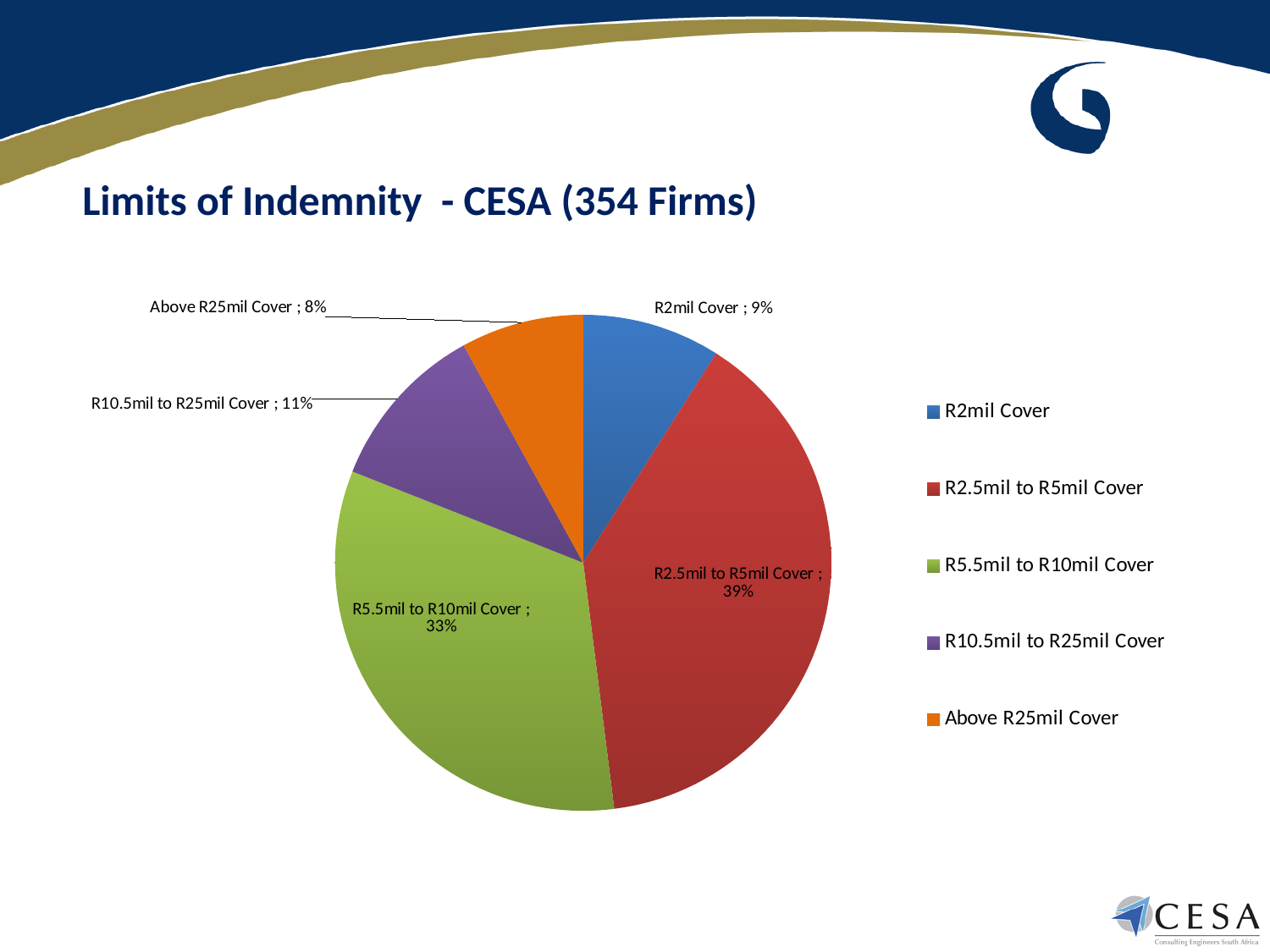
What share of the pie does R5.5mil to R10mil Cover represent? 33% What is the value shown for R2mil Cover? 9% Which category has the smallest slice of the pie? Above R25mil Cover What is the difference in percentage points between R2.5mil to R5mil Cover and R5.5mil to R10mil Cover? 6 Which is larger, the share for R2mil Cover or the share for R10.5mil to R25mil Cover? R10.5mil to R25mil Cover How many categories are shown in the pie chart? 5 What kind of chart is shown on the slide? Pie chart What is the value shown for Above R25mil Cover? 8% What share of the pie does R2.5mil to R5mil Cover represent? 39% What is the value shown for R10.5mil to R25mil Cover? 11% What is the title of the slide containing the chart? Limits of Indemnity - CESA (354 Firms) Which category has the largest slice of the pie? R2.5mil to R5mil Cover